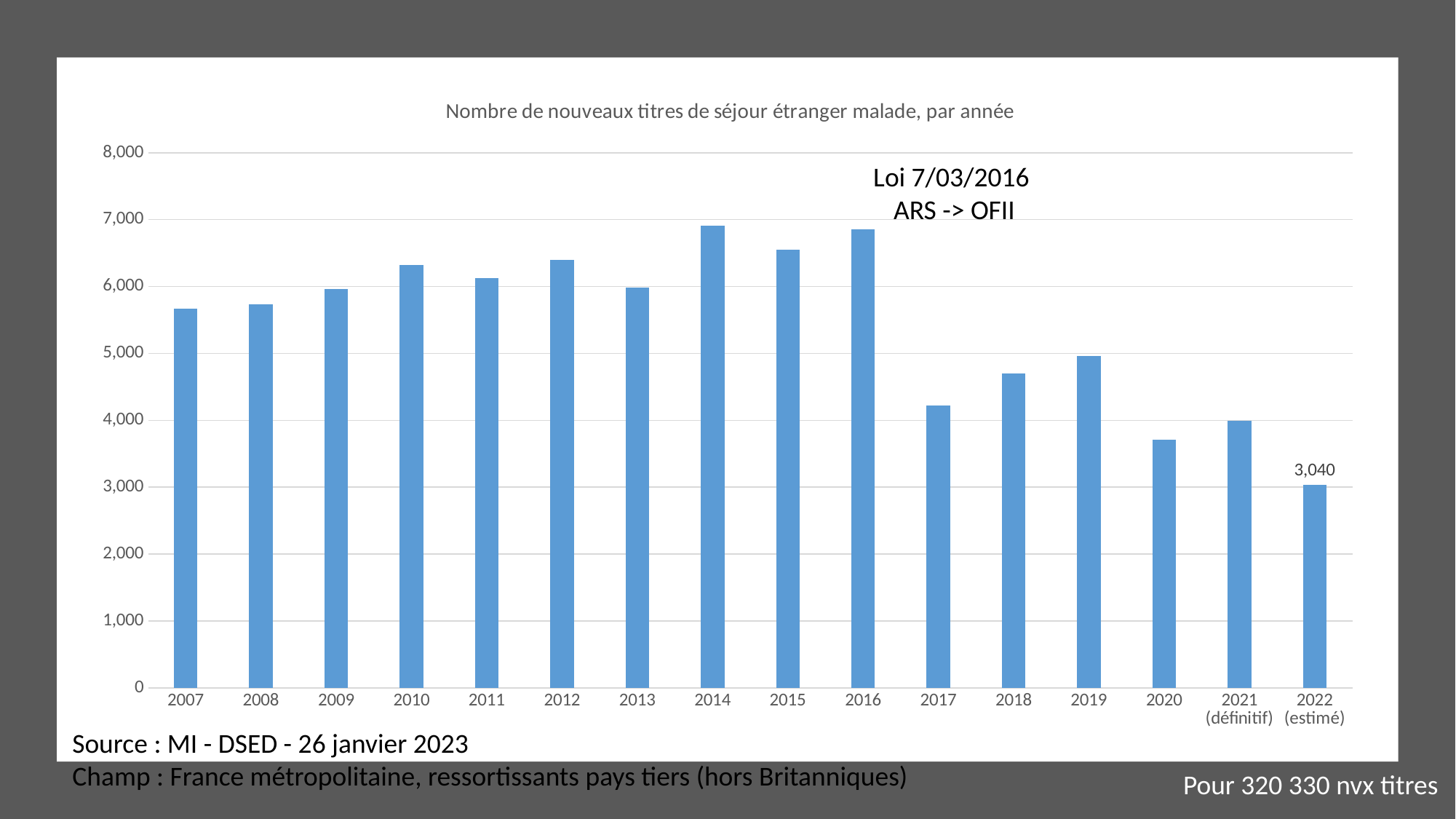
Which year has the larger value, 2016 or 2017? 2016 Do the values rise or fall from 2016 to 2022? Fall What is the value for 2022 (estimé)? 3,040 Which year has the larger value, 2011 or 2012? 2012 Is the value for 2017 greater or less than 5,000? less Is the value for 2020 greater or less than 4,000? less Is the value for 2010 greater or less than 6,000? greater How many years are shown on the x axis? 16 Which year has the lowest number of new titres de séjour étranger malade? 2022 What kind of chart is shown on the slide? Bar chart What is the title of the chart? Nombre de nouveaux titres de séjour étranger malade, par année